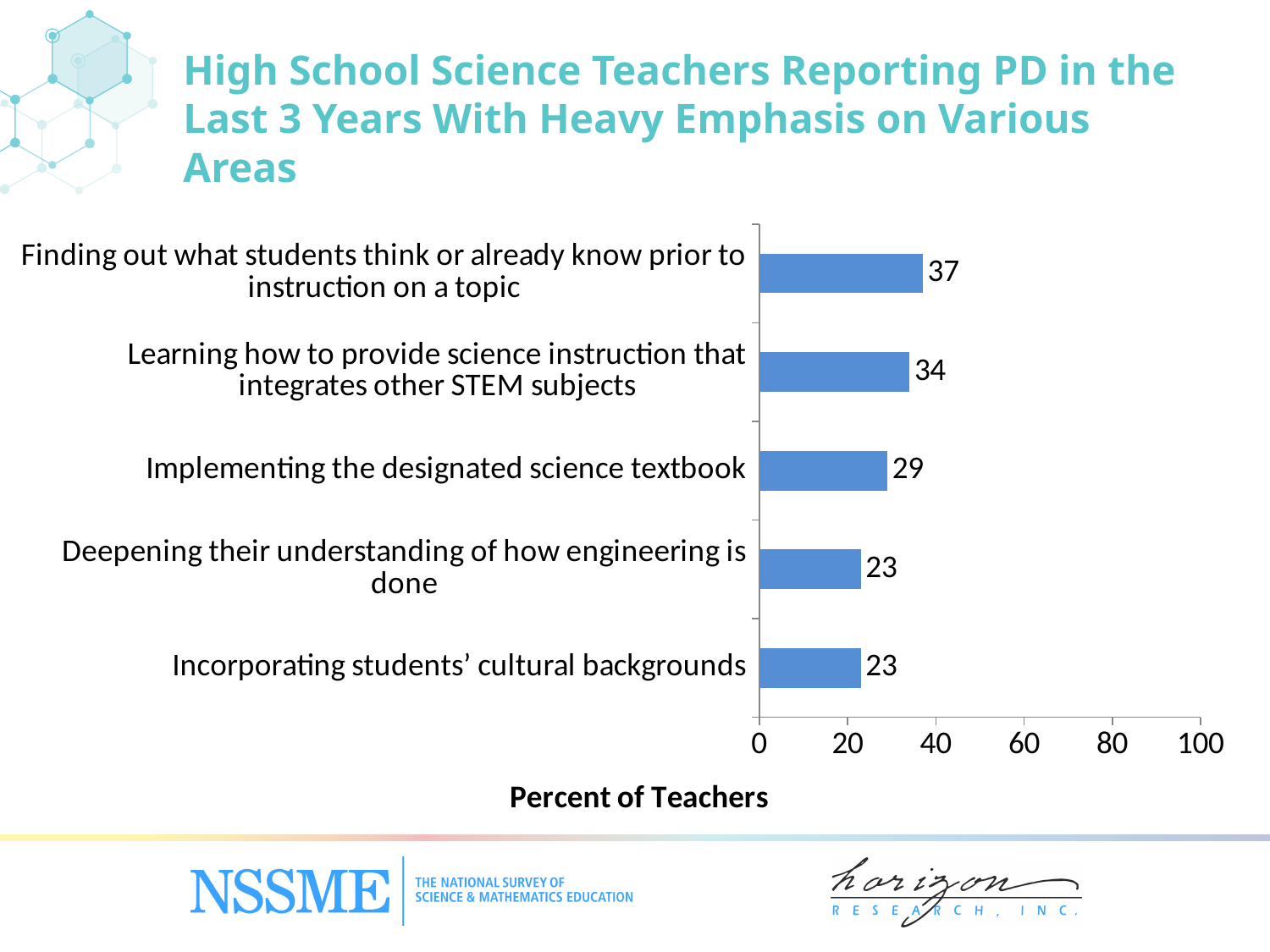
What is the difference between the values for finding out what students think or already know prior to instruction on a topic and implementing the designated science textbook? 8 Which is larger: the value for learning how to provide science instruction that integrates other STEM subjects or the value for deepening their understanding of how engineering is done? Learning how to provide science instruction that integrates other STEM subjects What is the value for implementing the designated science textbook? 29 What is the label of the horizontal axis? Percent of Teachers How many areas are shown in the chart? 5 What percent of teachers reported PD with heavy emphasis on finding out what students think or already know prior to instruction on a topic? 37 What kind of chart is shown on the slide? Bar chart Is the value for incorporating students' cultural backgrounds greater or less than 40? less What is the difference between the values for learning how to provide science instruction that integrates other STEM subjects and incorporating students' cultural backgrounds? 11 Which area has the highest percent of teachers? Finding out what students think or already know prior to instruction on a topic What is the value for learning how to provide science instruction that integrates other STEM subjects? 34 What is the maximum value shown on the horizontal axis? 100